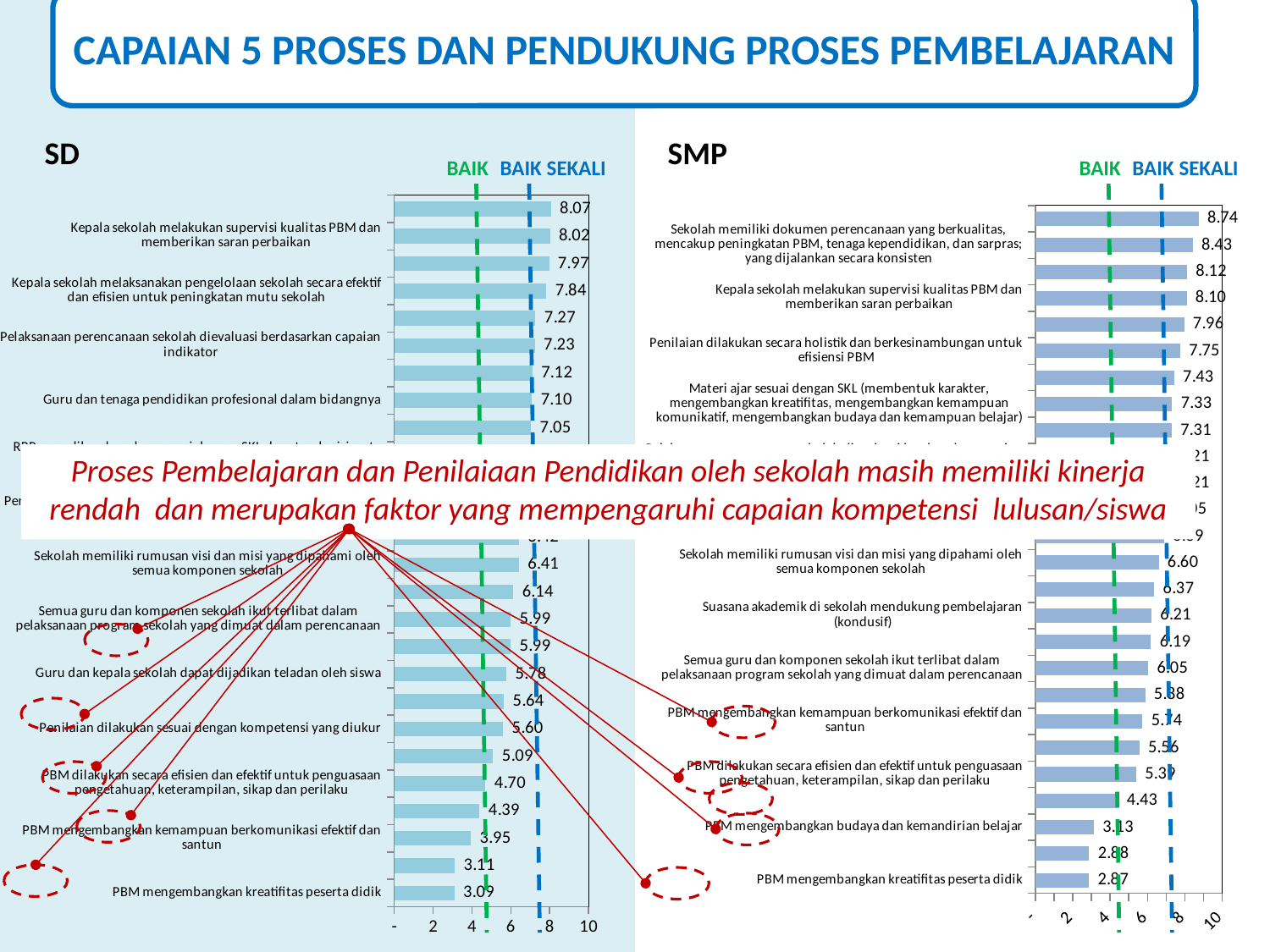
In the SMP chart, what is the highest value shown? 8.74 What type of chart is used for the SD data on the left of the slide? bar chart In the SD chart, what is the highest value shown? 8.07 In the SD chart, what is the value for 'PBM mengembangkan kreatifitas peserta didik'? 3.09 In the SMP chart, what is the value for 'PBM mengembangkan budaya dan kemandirian belajar'? 3.13 In the SMP chart, what is the value for 'PBM mengembangkan kreatifitas peserta didik'? 2.87 In the SMP chart, what is the difference between the highest value (8.74) and the value for 'PBM mengembangkan kreatifitas peserta didik' (2.87)? 5.87 In the SMP chart, what is the value for 'Sekolah memiliki dokumen perencanaan yang berkualitas, mencakup peningkatan PBM, tenaga kependidikan, dan sarpras; yang dijalankan secara konsisten'? 8.43 In the SD chart, what is the value for 'Penilaian dilakukan sesuai dengan kompetensi yang diukur'? 5.60 Which is larger: the value for 'PBM mengembangkan kreatifitas peserta didik' in the SD chart or in the SMP chart? SD (3.09) What are the two labelled dashed reference lines on each chart called? BAIK and BAIK SEKALI In the SD chart, is the value for 'Guru dan kepala sekolah dapat dijadikan teladan oleh siswa' greater or less than 4? greater